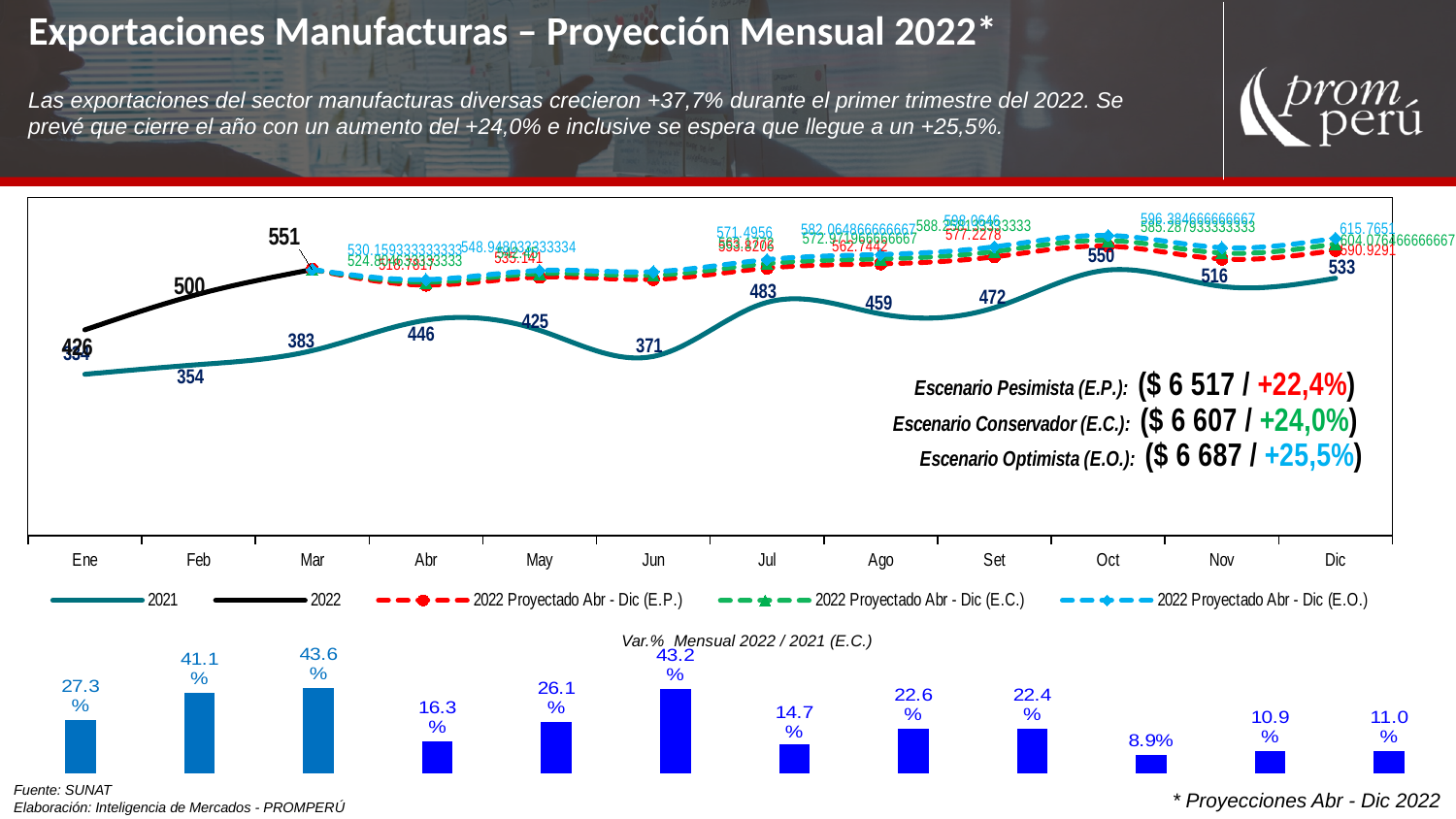
How many series does the legend of the top line chart list? 5 In the bottom bar chart (Var.% Mensual 2022 / 2021 (E.C.)), which month has the lowest value? Oct In the top line chart, what is the value of the 2022 series for Mar? 551 In the bottom bar chart (Var.% Mensual 2022 / 2021 (E.C.)), what is the difference between the values for Abr and Jul? 1.6% In the top line chart, does the 2022 series rise or fall from Ene to Mar? Rise How many months are shown in the bottom bar chart (Var.% Mensual 2022 / 2021 (E.C.))? 12 In the top line chart, what is the value of the 2021 series for Oct? 550 In the bottom bar chart (Var.% Mensual 2022 / 2021 (E.C.)), which is larger, the value for Ago or the value for Set? Ago In the top line chart, what is the difference between the 2021 values for Jul and Jun? 112 In the bottom bar chart (Var.% Mensual 2022 / 2021 (E.C.)), what is the value for Feb? 41.1% What kind of chart is the bottom chart (Var.% Mensual 2022 / 2021 (E.C.))? Bar chart In the bottom bar chart (Var.% Mensual 2022 / 2021 (E.C.)), which month has the highest value? Mar